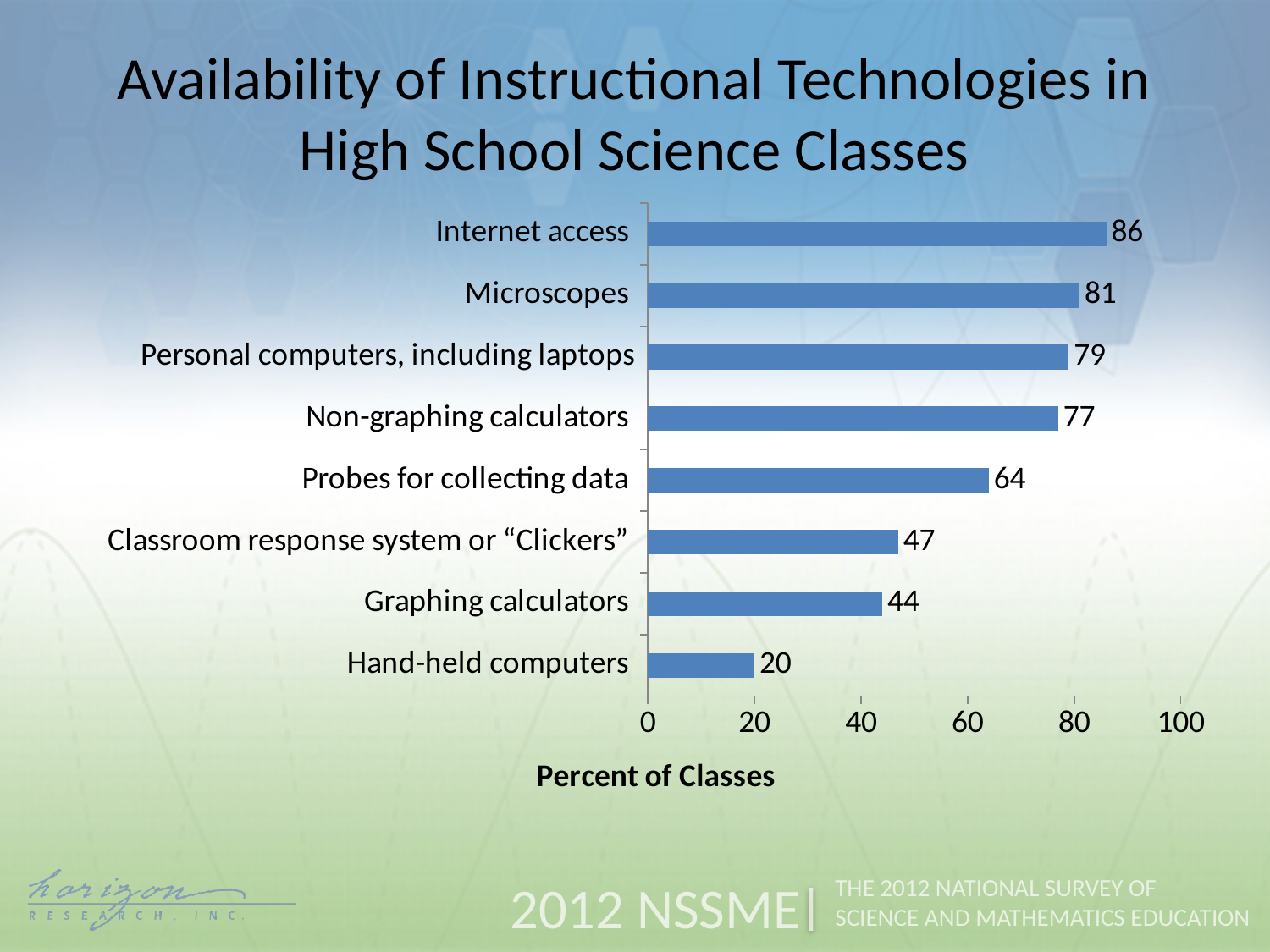
Which is larger, the value for Classroom response system or "Clickers" or the value for Probes for collecting data? Probes for collecting data What is the value for Graphing calculators? 44 What is the difference between the values for Microscopes and Hand-held computers? 61 What is the difference between the values for Non-graphing calculators and Graphing calculators? 33 What kind of chart is shown on the slide? Bar chart Is the value for Personal computers, including laptops greater or less than 60? greater What is the label of the horizontal axis? Percent of Classes What percent of classes have Internet access available? 86 How many categories are shown in the chart? 8 Which instructional technology has the highest percent of classes? Internet access What is the value for Probes for collecting data? 64 Which instructional technology has the lowest percent of classes? Hand-held computers